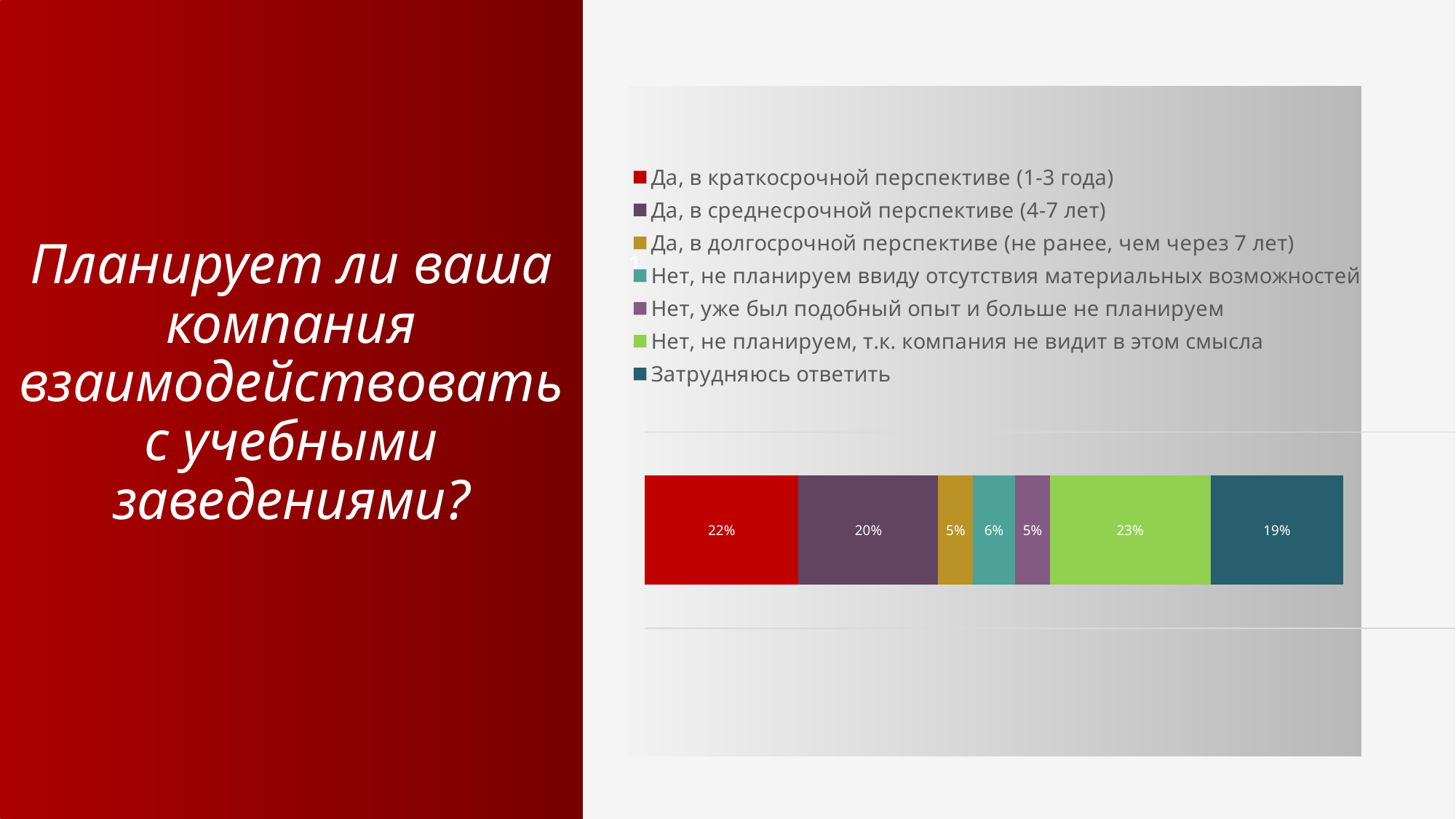
What is the value for "Да, в среднесрочной перспективе (4-7 лет)"? 20% What is the difference between "Да, в краткосрочной перспективе (1-3 года)" and "Да, в долгосрочной перспективе (не ранее, чем через 7 лет)"? 17% Which is larger: "Да, в краткосрочной перспективе (1-3 года)" or "Да, в среднесрочной перспективе (4-7 лет)"? Да, в краткосрочной перспективе (1-3 года) Which series has the highest value? Нет, не планируем, т.к. компания не видит в этом смысла What is the value for "Нет, не планируем ввиду отсутствия материальных возможностей"? 6% What is the total of all segments in the stacked bar? 100% How many series does the legend list? 7 What is the difference between "Нет, не планируем, т.к. компания не видит в этом смысла" and "Затрудняюсь ответить"? 4% What is the value for "Затрудняюсь ответить"? 19% What is the value for "Да, в краткосрочной перспективе (1-3 года)"? 22% What kind of chart is shown on the slide? stacked bar chart What colour is the segment for "Затрудняюсь ответить"? dark teal